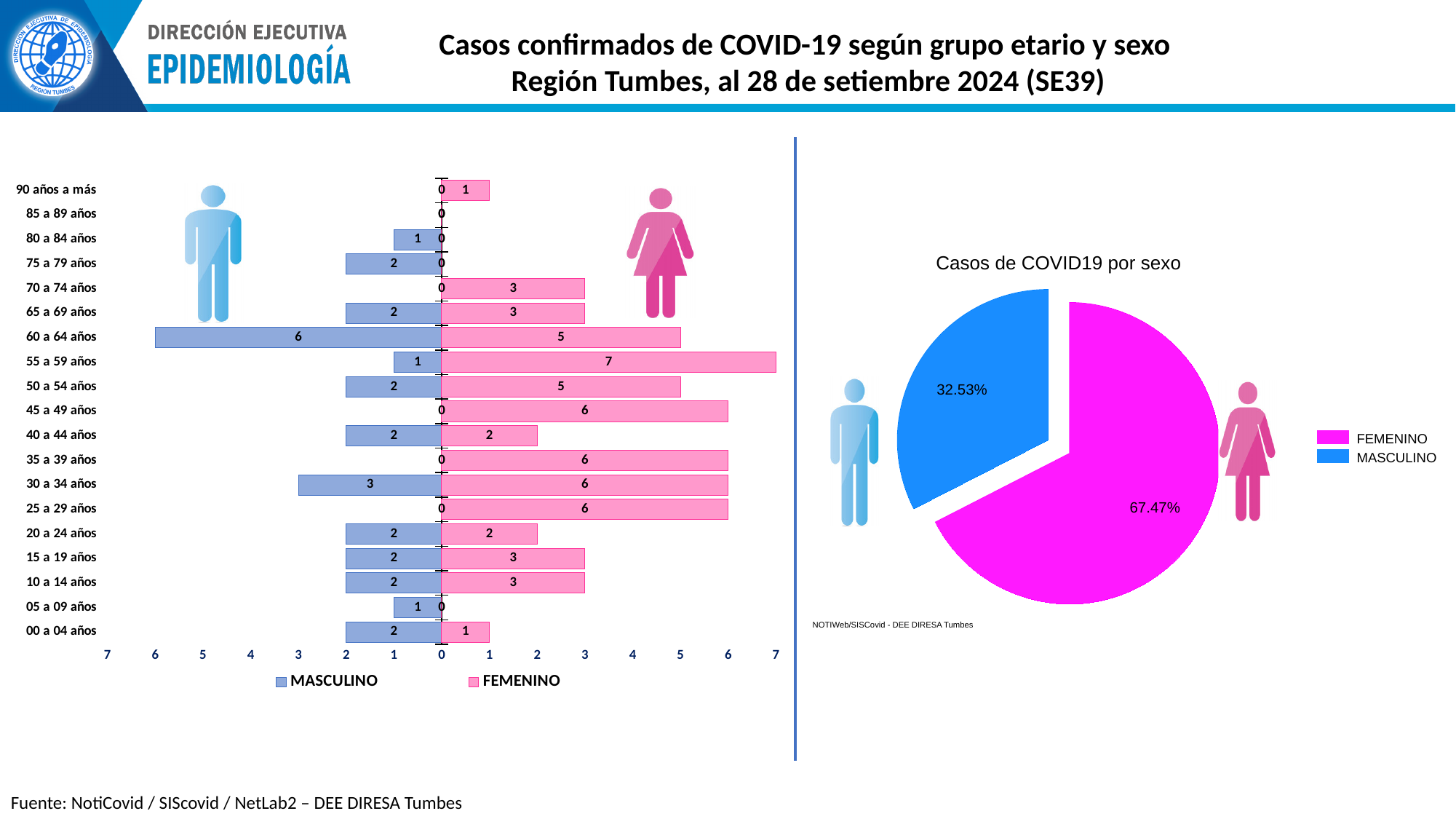
In the left bar chart, how many age groups are shown on the vertical axis? 19 In the left bar chart, which age group has the highest FEMENINO value? 55 a 59 años What kind of chart is the chart on the left side of the slide? Bar chart In the left bar chart, what is the difference between the FEMENINO and MASCULINO values for the 55 a 59 años group? 6 In the pie chart 'Casos de COVID19 por sexo', which colour represents MASCULINO? Blue In the left bar chart, how many FEMENINO cases are in the 55 a 59 años group? 7 In the left bar chart, how many MASCULINO cases are in the 60 a 64 años group? 6 In the left bar chart, how many series does the legend list? 2 In the left bar chart, which is larger for the 30 a 34 años group, MASCULINO or FEMENINO? FEMENINO In the pie chart 'Casos de COVID19 por sexo', what share is MASCULINO? 32.53% In the left bar chart, which age group has the highest MASCULINO value? 60 a 64 años In the pie chart 'Casos de COVID19 por sexo', what share is FEMENINO? 67.47%